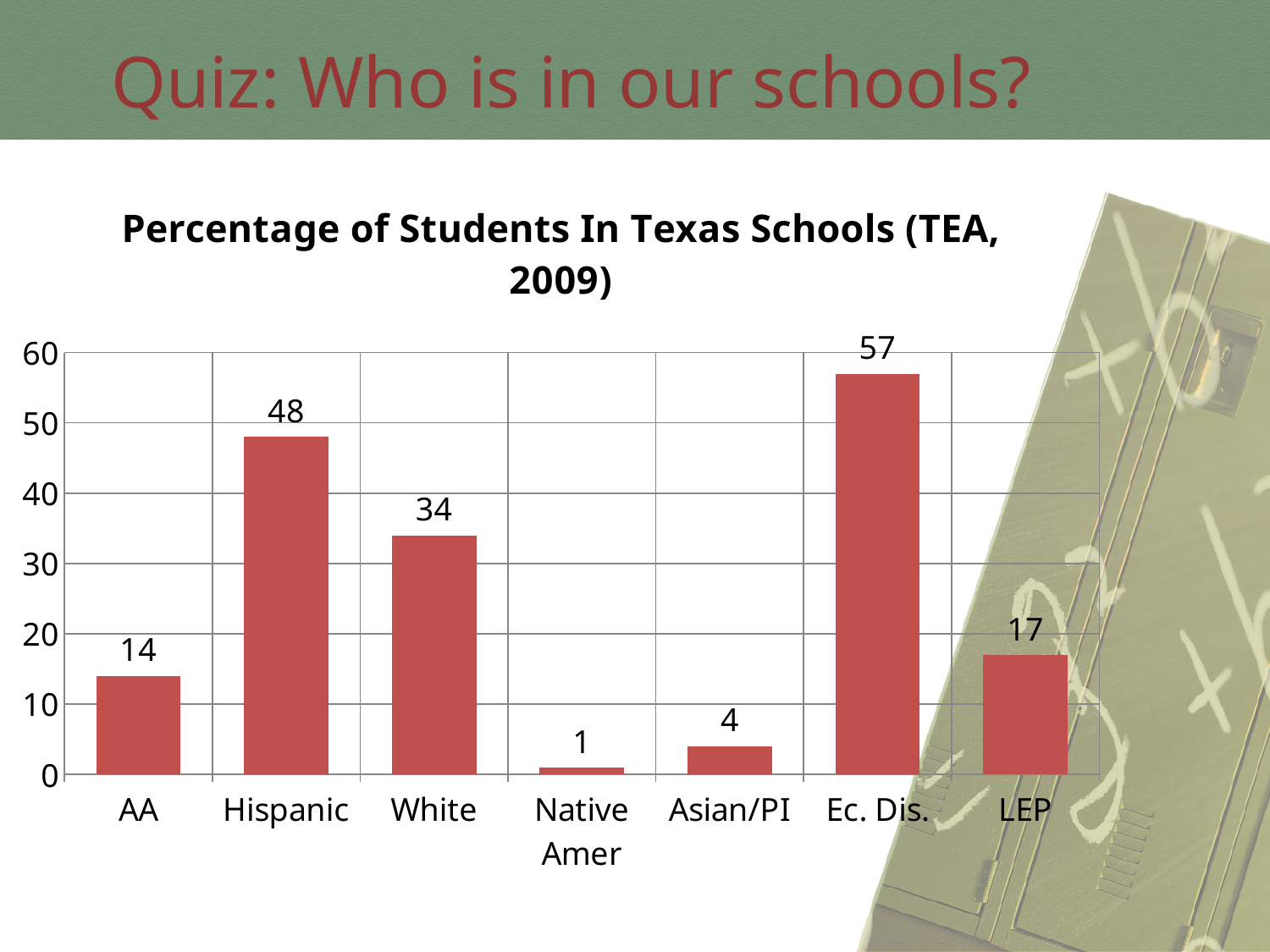
Which category has the lowest value? Native Amer What is the value for Ec. Dis.? 57 What is the difference between the values for Hispanic and White? 14 What kind of chart is shown on the slide? bar chart What is the title of the chart? Percentage of Students In Texas Schools (TEA, 2009) What is the value for LEP? 17 Which category has the highest value? Ec. Dis. What is the value for Hispanic students? 48 How many categories are shown on the x axis? 7 Which is larger, the value for AA or the value for LEP? LEP What is the value for Native Amer? 1 Is the value for White greater or less than 30? greater